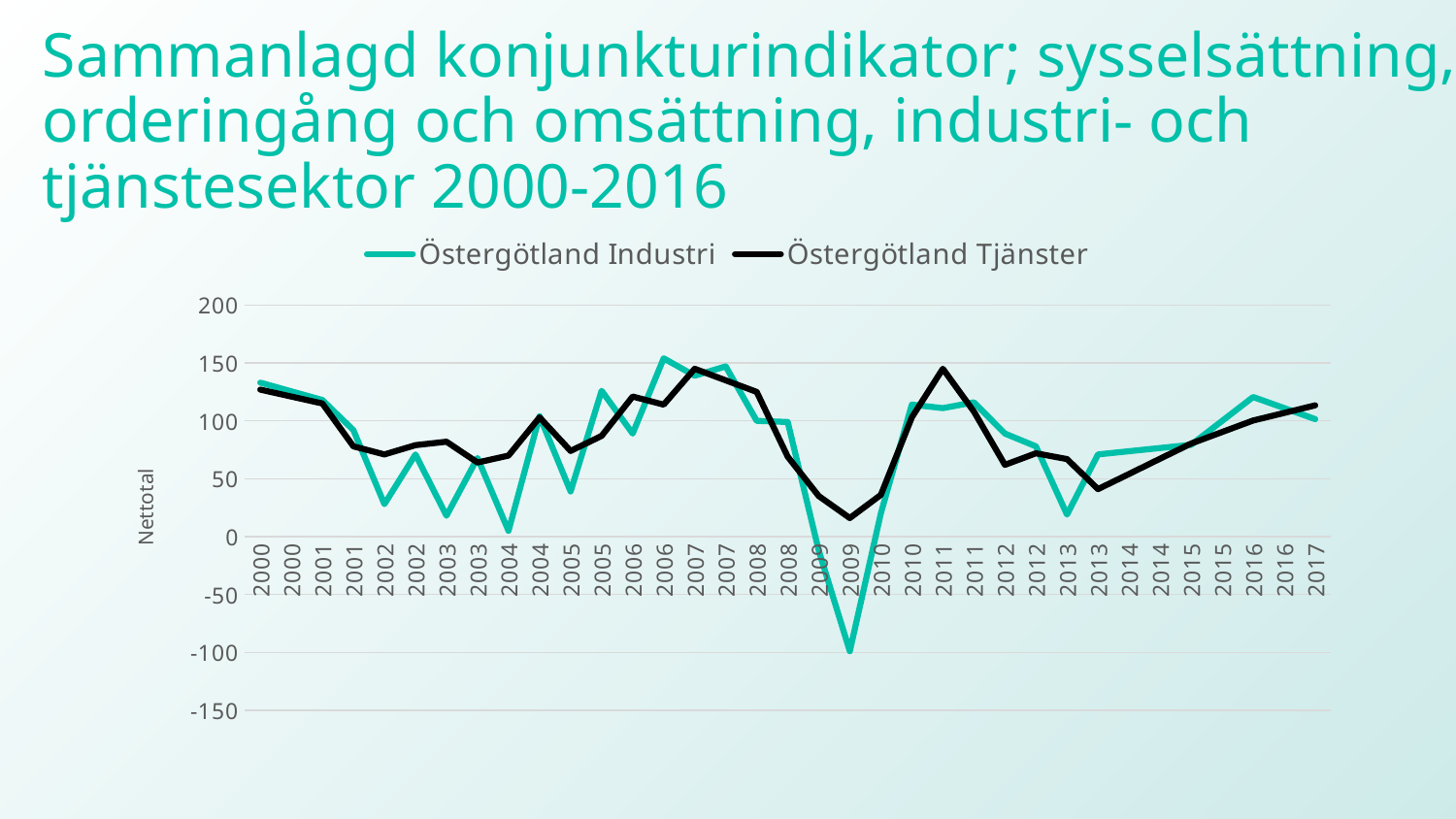
How many series does the legend list? 2 Does the Östergötland Industri line rise or fall from 2000 to 2002? Fall Is the lowest value of Östergötland Tjänster (in 2009) greater or less than 50? less At which year does the Östergötland Tjänster line reach its lowest point? 2009 Is the first 2000 value for Östergötland Industri greater or less than 100? greater At which year does the Östergötland Industri line reach its lowest point? 2009 Which series is drawn in black? Östergötland Tjänster What is the label on the vertical axis? Nettotal Is the lowest value of Östergötland Industri (in 2009) greater or less than -50? less What kind of chart is shown on the slide? Line chart At the lowest point in 2009, which series has the higher value, Östergötland Industri or Östergötland Tjänster? Östergötland Tjänster Does the Östergötland Tjänster line rise or fall between 2013 and 2016? Rise